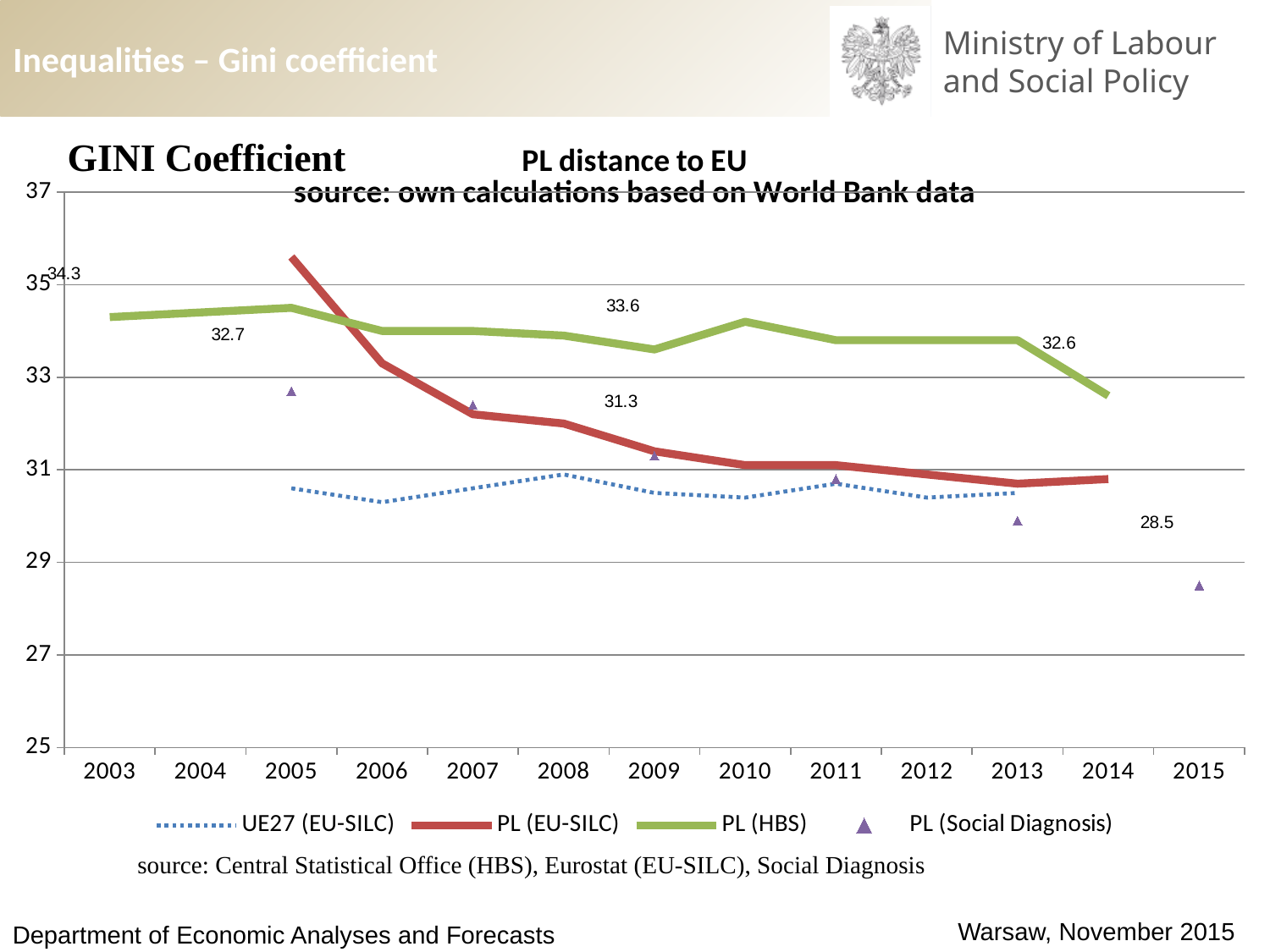
What is the value labelled for PL (HBS) in 2014? 32.6 How many years are shown on the x axis? 13 How many series does the legend list? 4 What is the value labelled for PL (HBS) in 2003? 34.3 Is the value for UE27 (EU-SILC) in 2006 greater or less than 31? less What is the value labelled for PL (Social Diagnosis) in 2015? 28.5 What is the difference between the PL (Social Diagnosis) values labelled for 2005 and 2015? 4.2 Which series is drawn with a dotted line? UE27 (EU-SILC) Does the PL (EU-SILC) series rise or fall from 2005 to 2013? Fall What kind of chart is shown on the slide? Line chart Which series has the highest value in 2005, PL (EU-SILC) or PL (HBS)? PL (EU-SILC)